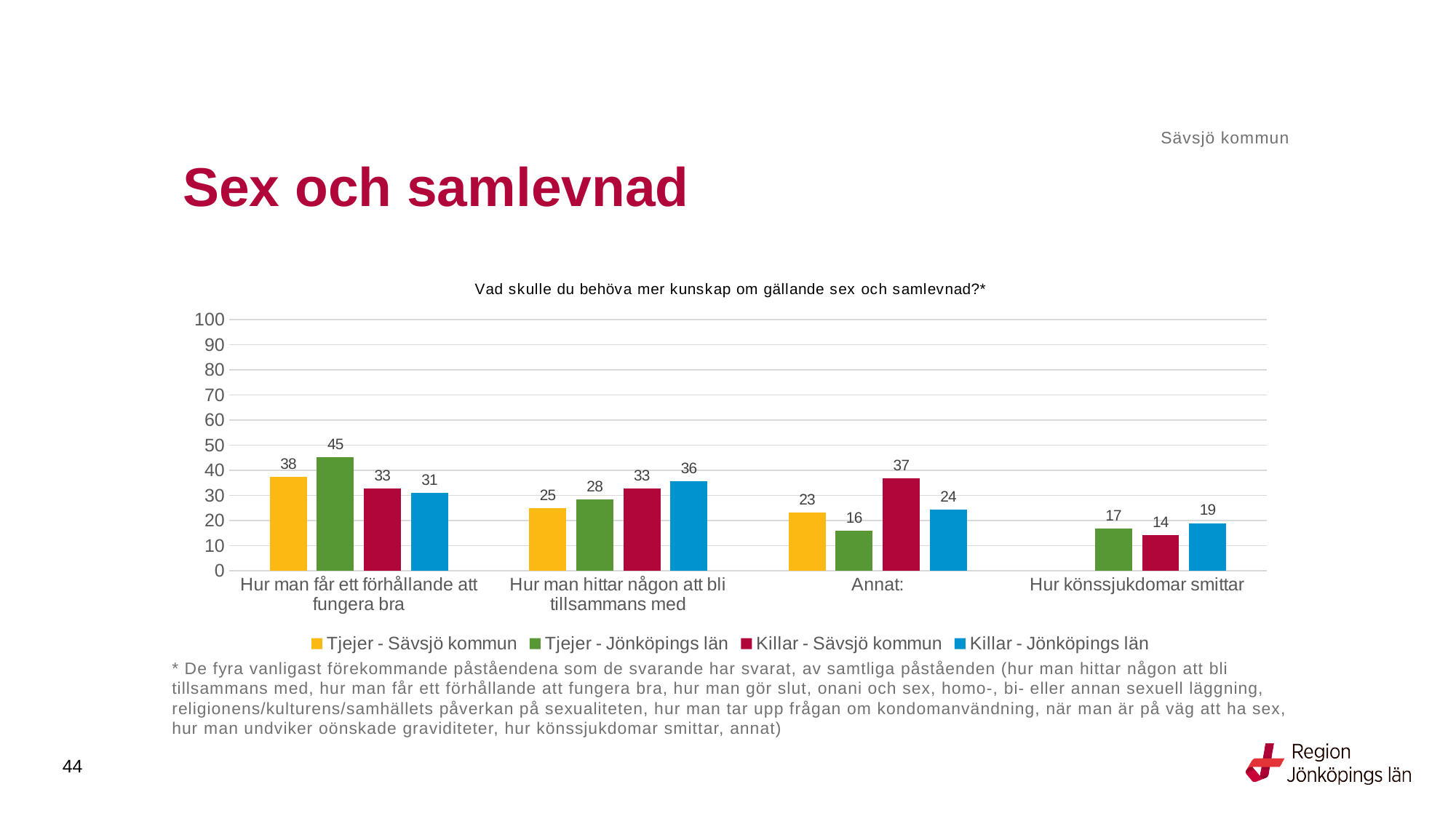
What is the title of the chart? Vad skulle du behöva mer kunskap om gällande sex och samlevnad?* What is the difference between the Tjejer - Jönköpings län value and the Killar - Jönköpings län value in the category "Hur man får ett förhållande att fungera bra"? 14 Is the value for Killar - Sävsjö kommun in the category "Hur könssjukdomar smittar" greater or less than 20? less How many categories are shown on the x axis of the chart? 4 What is the value for Tjejer - Jönköpings län in the category "Hur man får ett förhållande att fungera bra"? 45 In the category "Annat:", which is larger: the value for Tjejer - Sävsjö kommun or the value for Tjejer - Jönköpings län? Tjejer - Sävsjö kommun Which category has the lowest value for Killar - Sävsjö kommun? Hur könssjukdomar smittar What kind of chart is shown on the slide? bar chart What is the value for Killar - Sävsjö kommun in the category "Annat:"? 37 How many series does the legend list? 4 What is the value for Killar - Jönköpings län in the category "Hur man hittar någon att bli tillsammans med"? 36 Which category has the highest value for Tjejer - Sävsjö kommun? Hur man får ett förhållande att fungera bra